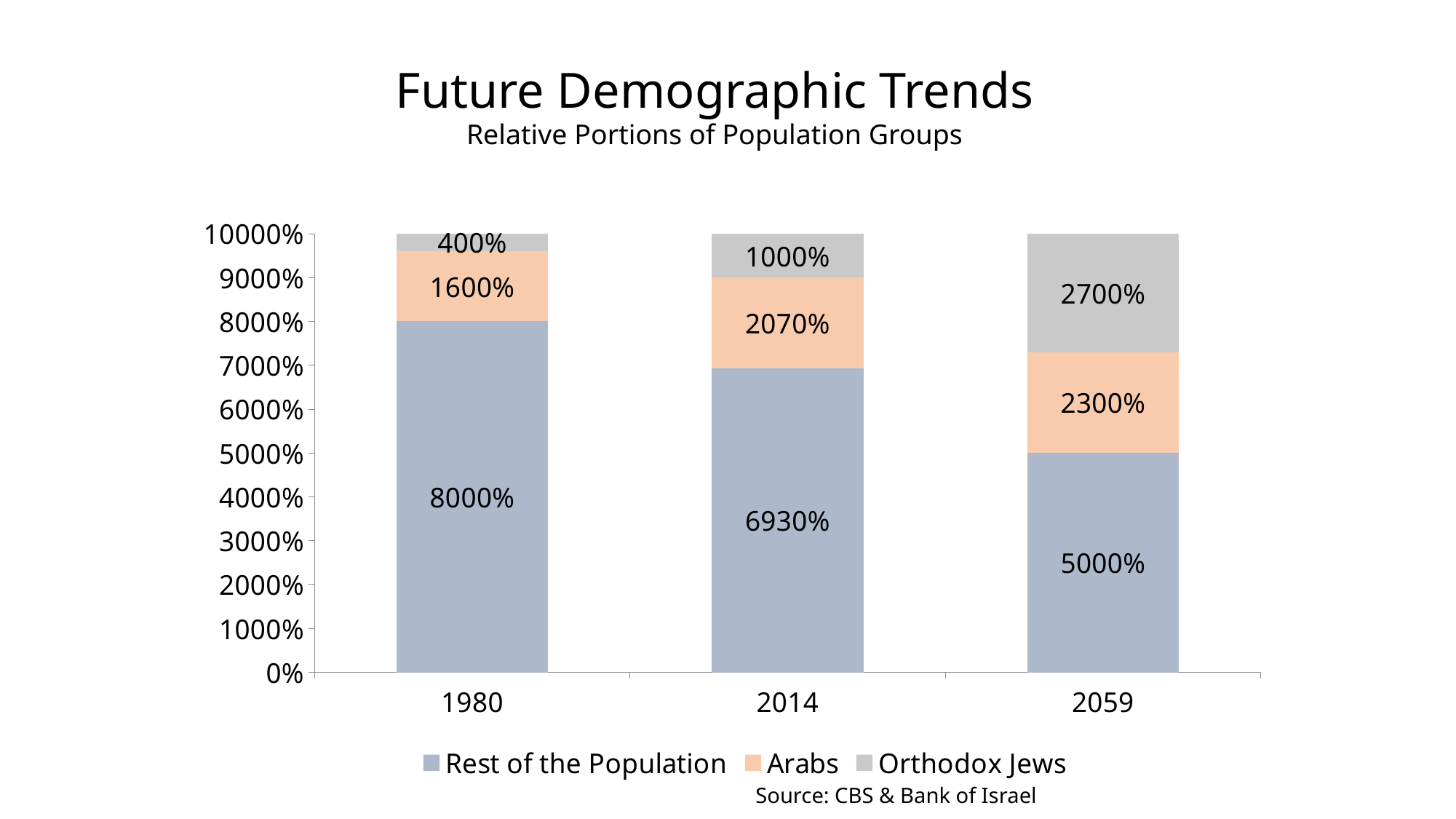
Does the value for Orthodox Jews rise or fall from 1980 to 2059? Rise In which year is the value for Rest of the Population lowest? 2059 What is the value for Rest of the Population in 1980? 8000% In which year is the value for Orthodox Jews highest? 2059 How many series does the legend list? 3 What is the value for Orthodox Jews in 1980? 400% What is the value for Arabs in 2014? 2070% What is the value for Orthodox Jews in 2059? 2700% Which is larger in 2014: the value for Arabs or the value for Orthodox Jews? Arabs What kind of chart is shown on the slide? Stacked bar chart What is the difference between the Rest of the Population values in 1980 and 2059? 3000% How many years are shown on the x axis? 3